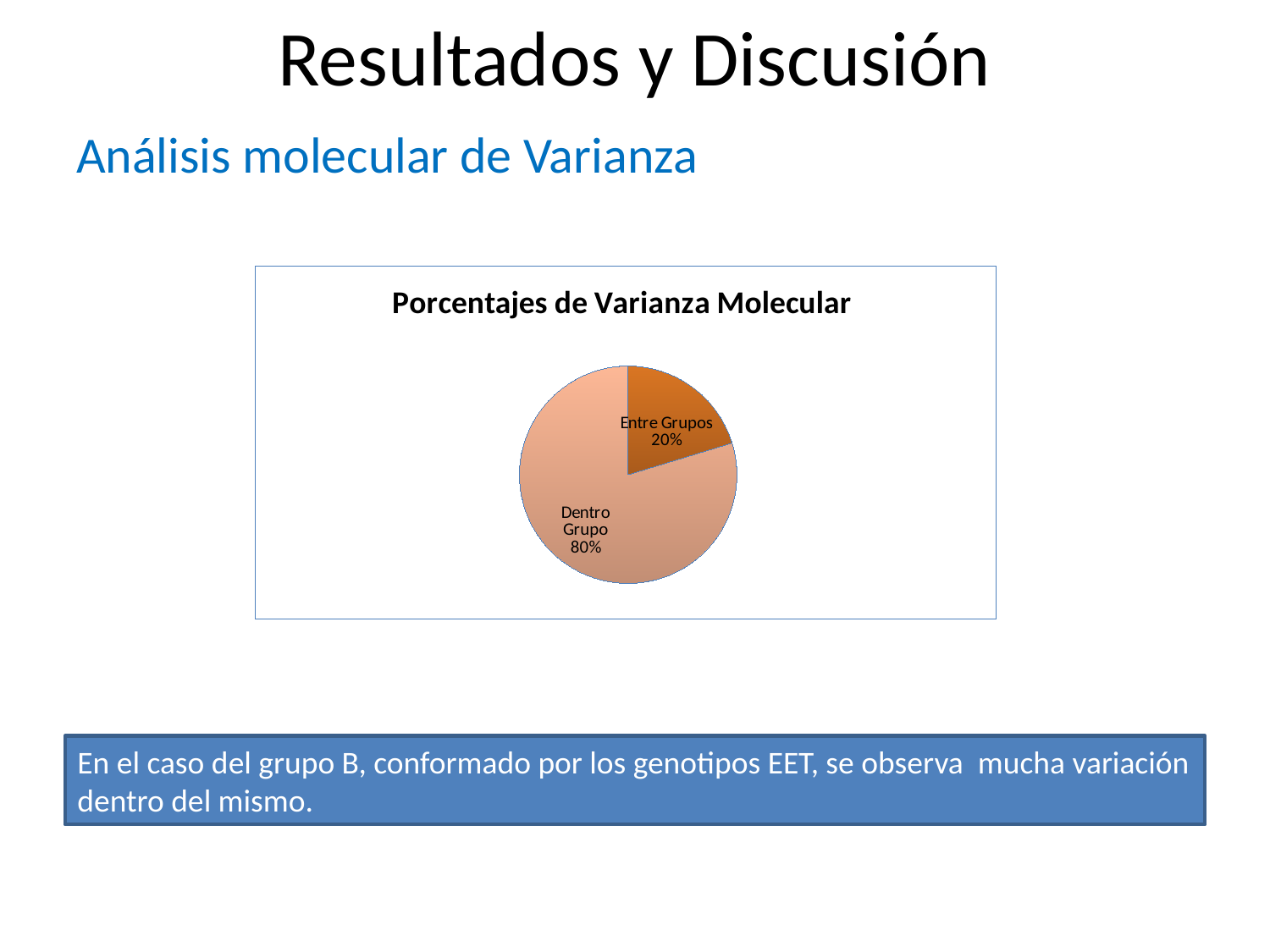
Which slice of the pie is the largest? Dentro Grupo What is the title of the chart? Porcentajes de Varianza Molecular How many slices does the pie chart have? 2 What is the total of the two slices shown in the pie chart? 100% Which slice of the pie is the smallest? Entre Grupos Which is larger, Entre Grupos or Dentro Grupo? Dentro Grupo What percentage is shown for Dentro Grupo? 80% What share of the pie does Entre Grupos represent? 20% What percentage is shown for Entre Grupos? 20% Which slice is drawn in the darker orange colour? Entre Grupos What is the difference in percentage points between Dentro Grupo and Entre Grupos? 60 What type of chart is shown on the slide? pie chart